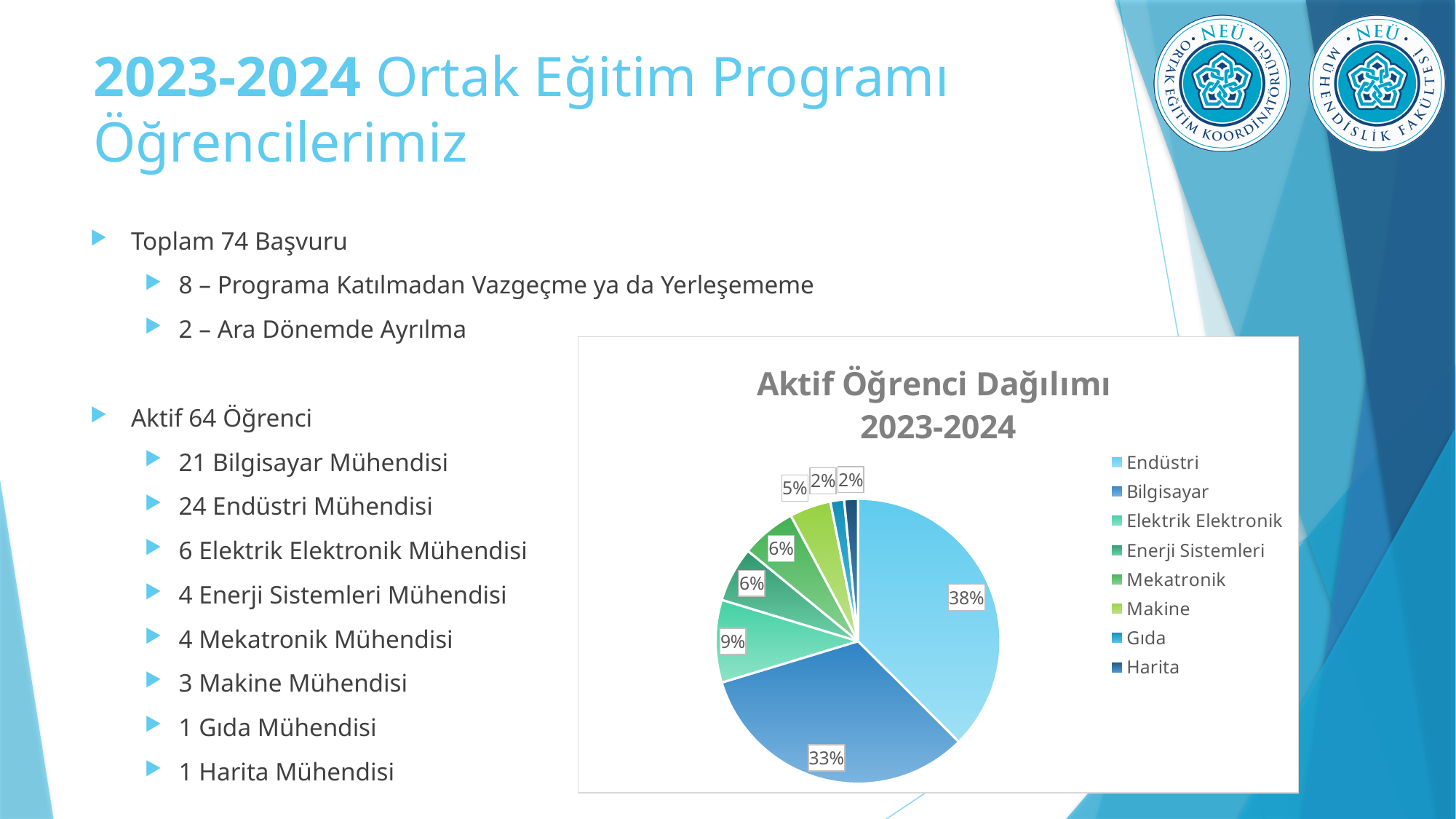
What share of the pie does Endüstri have? 38% What share of the pie does Bilgisayar have? 33% Which legend entry is listed last? Harita Which slice is larger, Elektrik Elektronik or Makine? Elektrik Elektronik What is the combined share of the Gıda and Harita slices? 4% What kind of chart is shown on the slide? pie chart How many categories does the legend list? 8 What is the title of the chart? Aktif Öğrenci Dağılımı 2023-2024 What share of the pie does Elektrik Elektronik have? 9% What is the difference in percentage points between the Endüstri and Bilgisayar slices? 5 Which category has the largest slice of the pie? Endüstri What share of the pie does Makine have? 5%